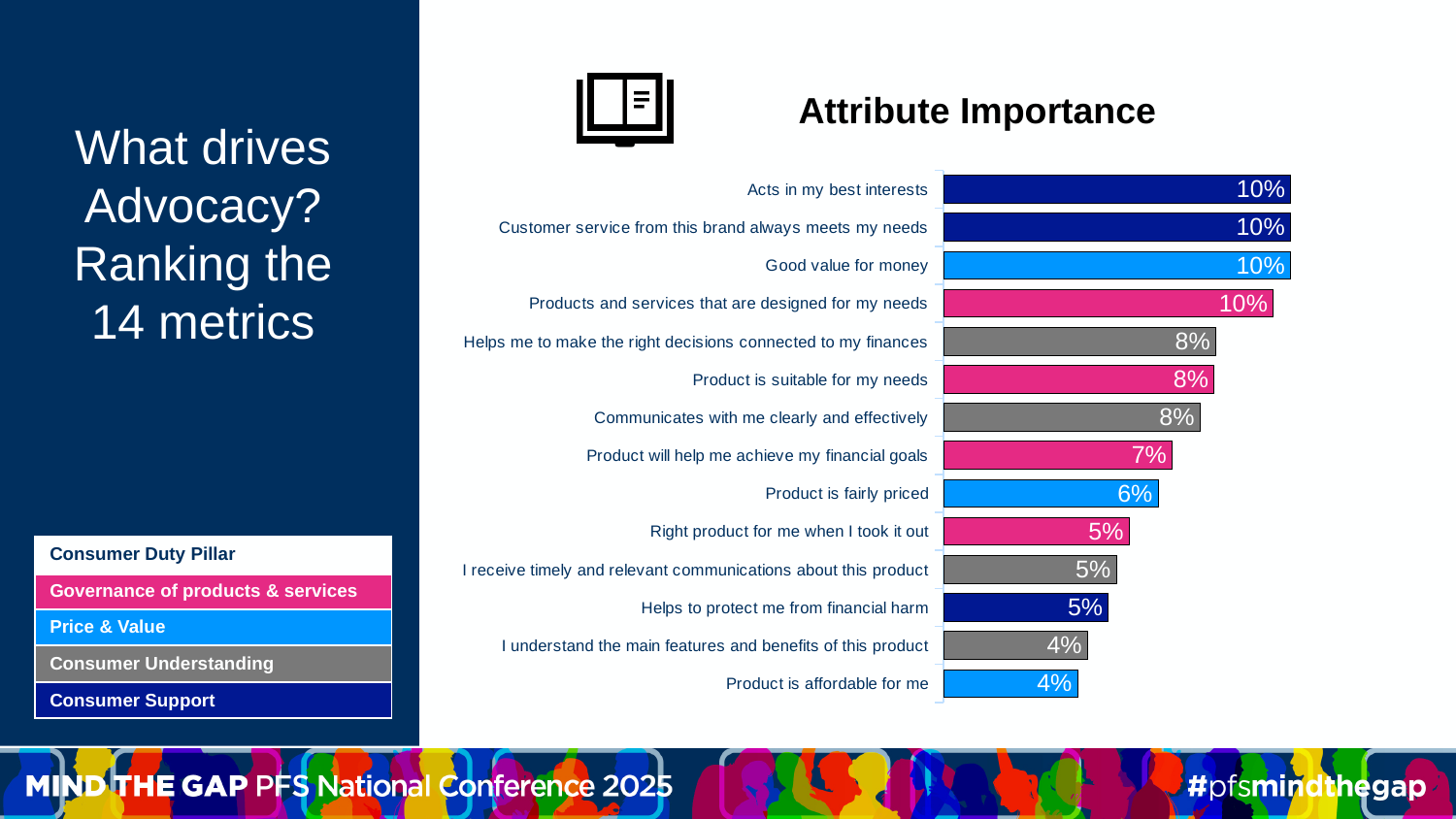
What is the difference between the values for "Acts in my best interests" and "Product is affordable for me"? 6% What is the value for "Product is affordable for me"? 4% Which has the larger value: "Product is fairly priced" or "Helps to protect me from financial harm"? Product is fairly priced What is the value for "Acts in my best interests" in the Attribute Importance chart? 10% What is the value for "Helps to protect me from financial harm"? 5% What kind of chart is the Attribute Importance chart? Bar chart How many attributes are plotted in the Attribute Importance chart? 14 What is the value for "Product is fairly priced"? 6% What is the difference between the values for "Product is suitable for my needs" and "Right product for me when I took it out"? 3% What is the value for "Communicates with me clearly and effectively"? 8% Do the values in the Attribute Importance chart increase or decrease from the top bar to the bottom bar? Decrease What is the value for "Product will help me achieve my financial goals"? 7%